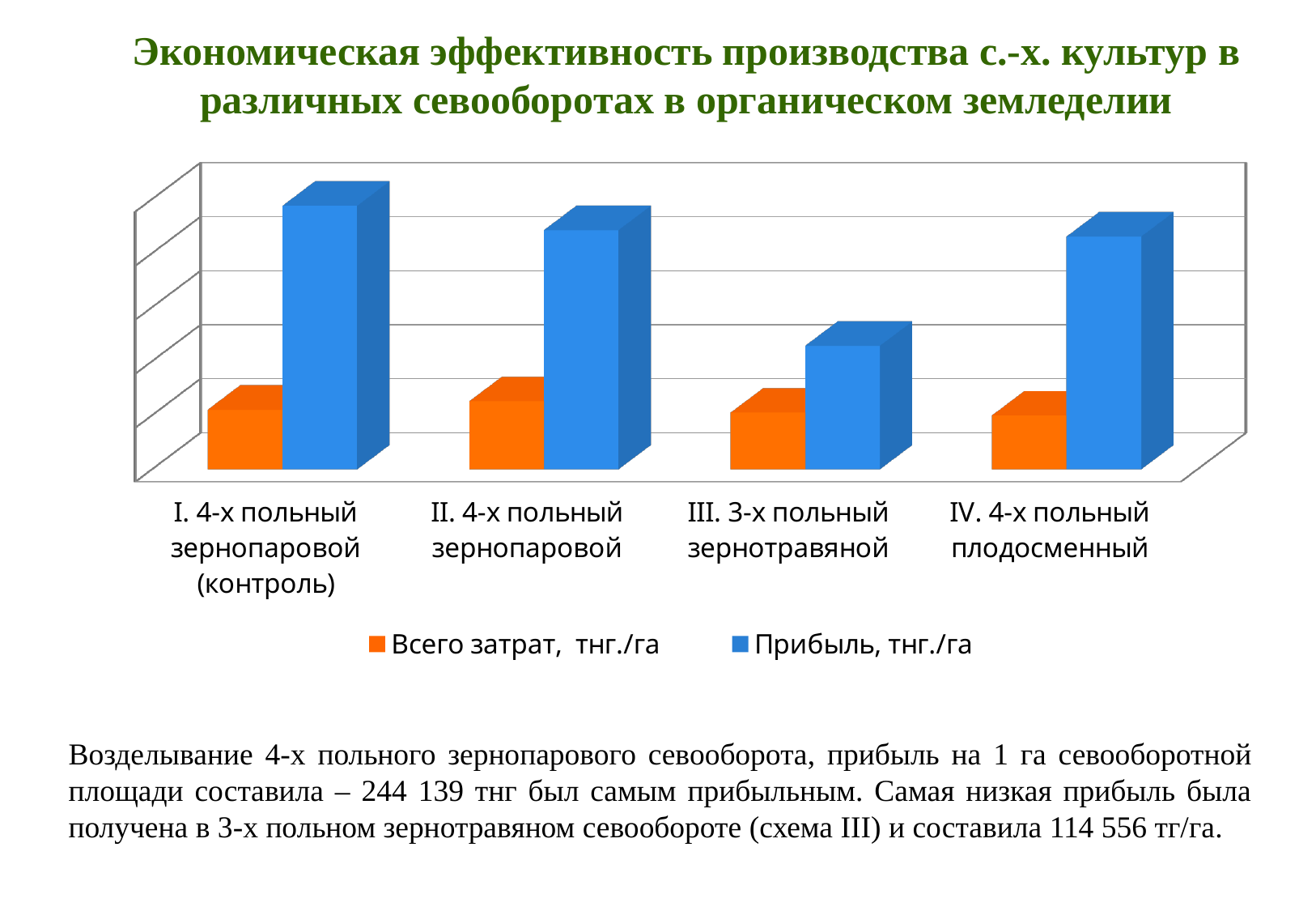
Which category has the lowest value for Прибыль, тнг./га? III. 3-х польный зернотравяной Which series is shown in blue in the chart? Прибыль, тнг./га Which category has the larger Прибыль, тнг./га: I. 4-х польный зернопаровой (контроль) or II. 4-х польный зернопаровой? I. 4-х польный зернопаровой (контроль) How many crop rotation categories are shown on the x axis of the chart? 4 Which series is shown in orange in the chart? Всего затрат, тнг./га Which category has the highest value for Прибыль, тнг./га? I. 4-х польный зернопаровой (контроль) Which is larger for I. 4-х польный зернопаровой (контроль): Всего затрат, тнг./га or Прибыль, тнг./га? Прибыль, тнг./га Which category has the larger Прибыль, тнг./га: III. 3-х польный зернотравяной or IV. 4-х польный плодосменный? IV. 4-х польный плодосменный How many series does the chart legend list? 2 What kind of chart is shown on the slide? bar chart